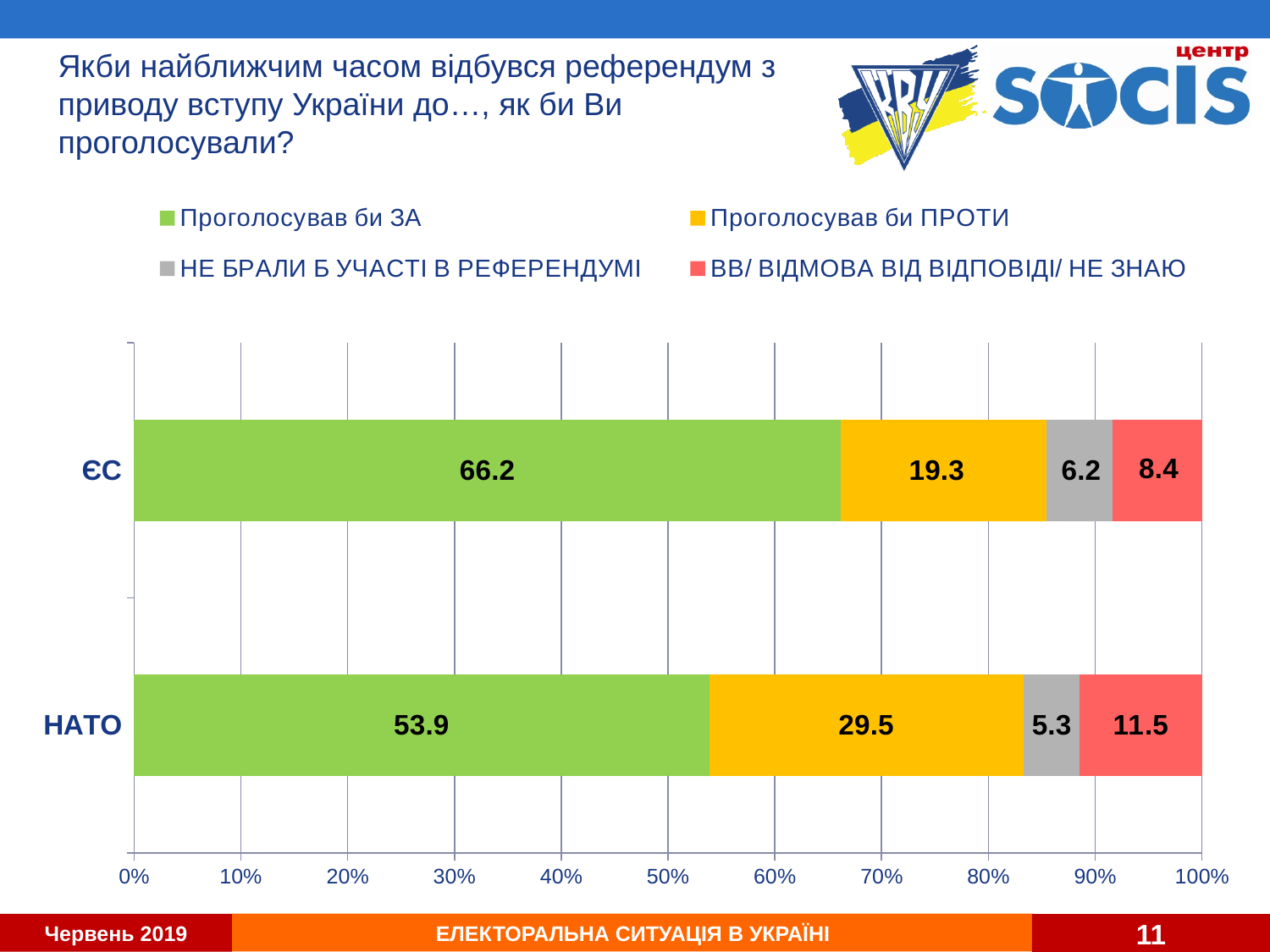
What is the difference between the "Проголосував би ПРОТИ" values for НАТО and ЄС? 10.2 What kind of chart is shown on the slide? Stacked bar chart Which category has the lower value for "Проголосував би ПРОТИ"? ЄС What is the value for "НЕ БРАЛИ Б УЧАСТІ В РЕФЕРЕНДУМІ" for ЄС? 6.2 What is the difference between the "Проголосував би ЗА" values for ЄС and НАТО? 12.3 What is the value for "Проголосував би ПРОТИ" for НАТО? 29.5 How many categories are shown on the chart? 2 What is the value for "Проголосував би ЗА" for ЄС? 66.2 How many series does the legend list? 4 Which category has the higher value for "Проголосував би ЗА", ЄС or НАТО? ЄС What is the value for "ВВ/ ВІДМОВА ВІД ВІДПОВІДІ/ НЕ ЗНАЮ" for НАТО? 11.5 Which colour represents "Проголосував би ПРОТИ" in the chart? Yellow